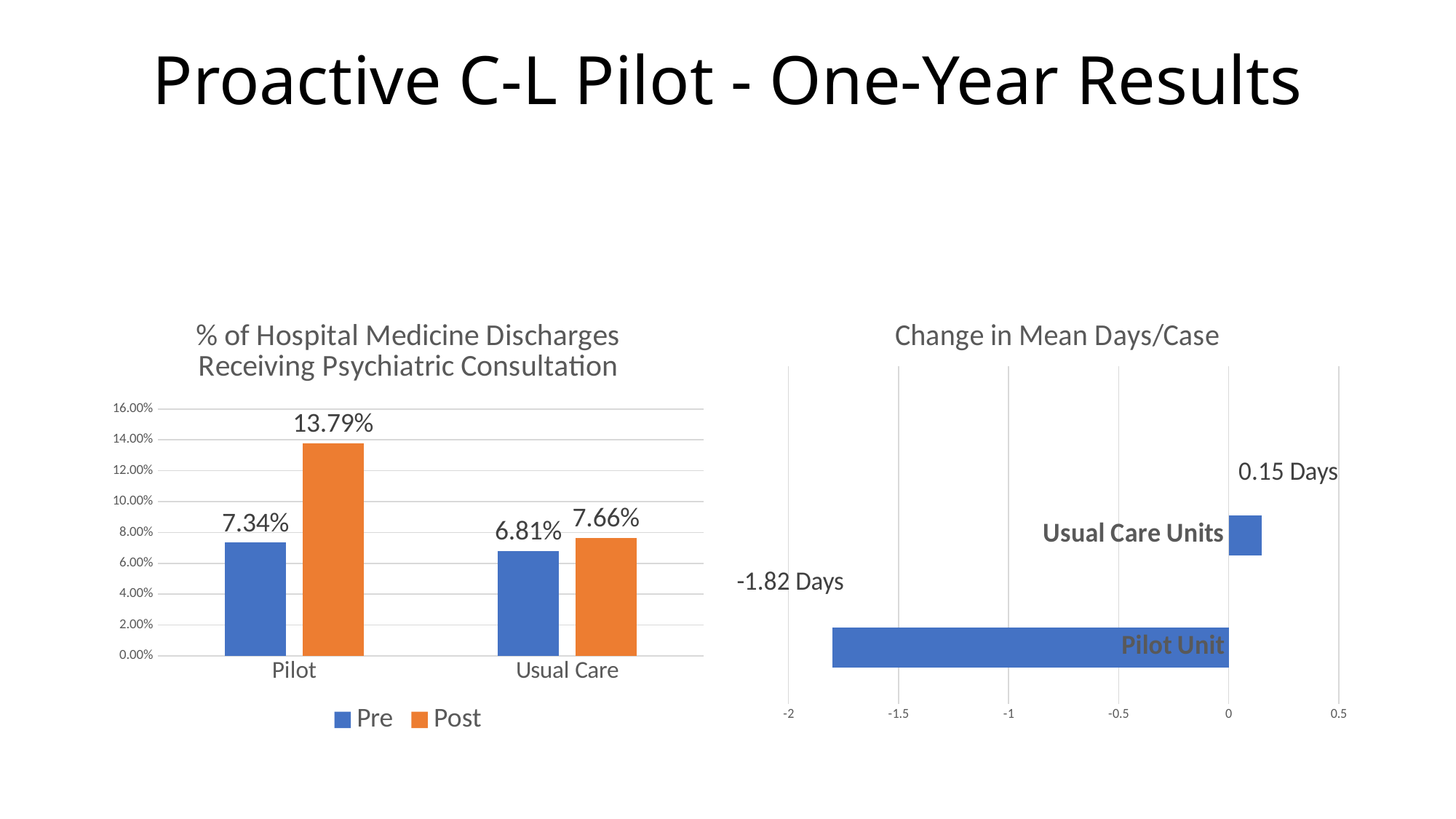
In the '% of Hospital Medicine Discharges Receiving Psychiatric Consultation' chart, what is the Post value for Pilot? 13.79% In the 'Change in Mean Days/Case' chart, what is the value for Usual Care Units? 0.15 Days What kind of chart is the 'Change in Mean Days/Case' chart? Bar chart In the '% of Hospital Medicine Discharges Receiving Psychiatric Consultation' chart, what is the Pre value for Pilot? 7.34% In the '% of Hospital Medicine Discharges Receiving Psychiatric Consultation' chart, which bar is the highest? Pilot Post In the '% of Hospital Medicine Discharges Receiving Psychiatric Consultation' chart, how many categories are shown on the x axis? 2 In the '% of Hospital Medicine Discharges Receiving Psychiatric Consultation' chart, what colour are the Post bars? Orange In the '% of Hospital Medicine Discharges Receiving Psychiatric Consultation' chart, which is larger: the Post value for Pilot or the Post value for Usual Care? Post value for Pilot In the '% of Hospital Medicine Discharges Receiving Psychiatric Consultation' chart, what is the difference between the Post and Pre values for Pilot? 6.45% In the '% of Hospital Medicine Discharges Receiving Psychiatric Consultation' chart, how many series does the legend list? 2 In the '% of Hospital Medicine Discharges Receiving Psychiatric Consultation' chart, what is the Pre value for Usual Care? 6.81% In the 'Change in Mean Days/Case' chart, what is the value for Pilot Unit? -1.82 Days